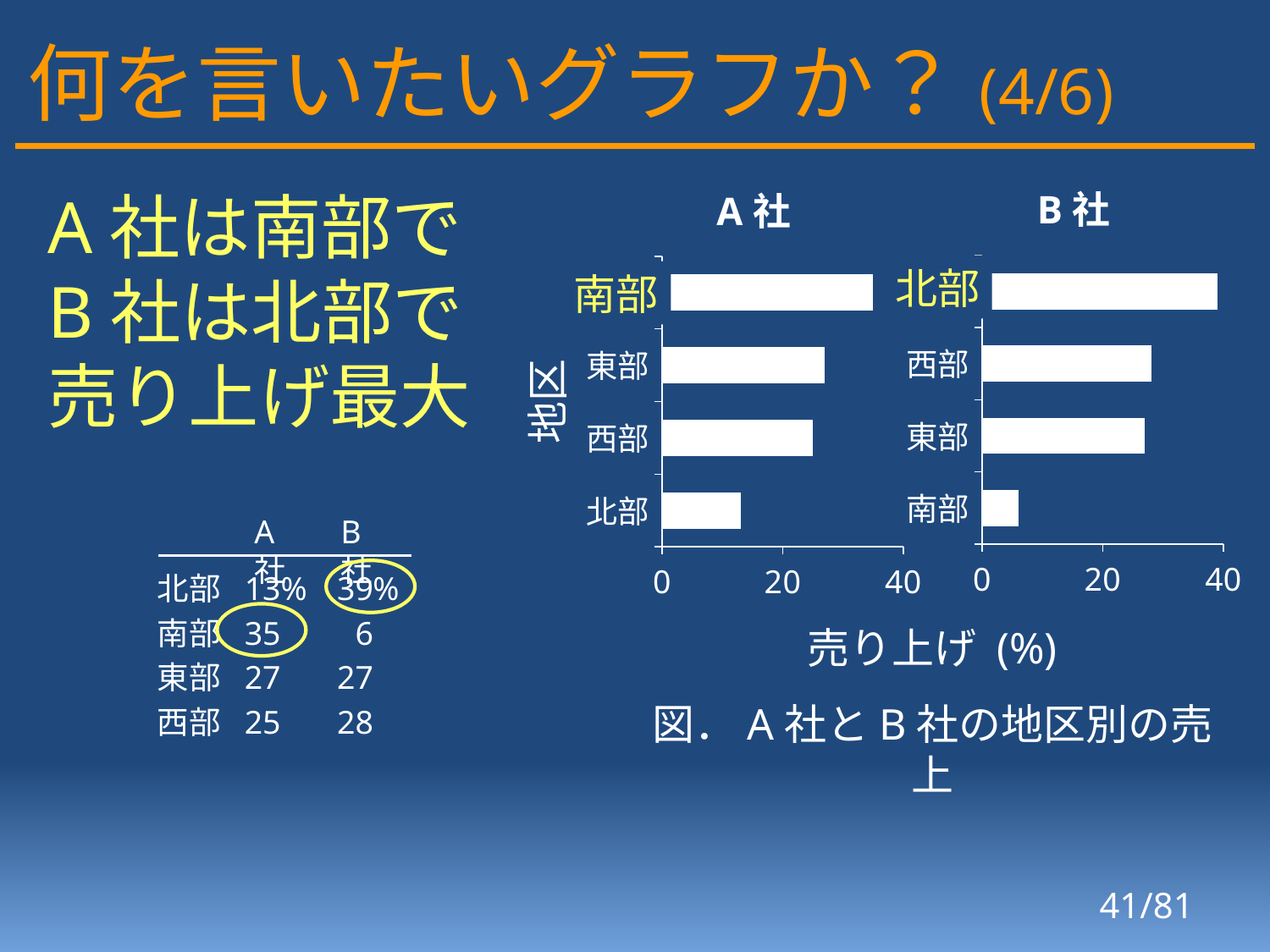
In the A社 chart, is the value for 南部 greater or less than 20? greater In the B社 chart, is the value for 南部 greater or less than 20? less What is the label of the horizontal axis shared by the two charts? 売り上げ (%) What is the title of the chart on the right? B社 In the B社 chart, which is larger, the value for 北部 or the value for 南部? 北部 In the A社 chart, which region has the lowest value? 北部 In the B社 chart, which region has the highest value? 北部 In the A社 chart, which region has the highest value? 南部 What kind of chart is the A社 chart? bar chart How many regions are shown in the B社 chart? 4 In the A社 chart, is the value for 北部 greater or less than 20? less In the B社 chart, which region has the lowest value? 南部